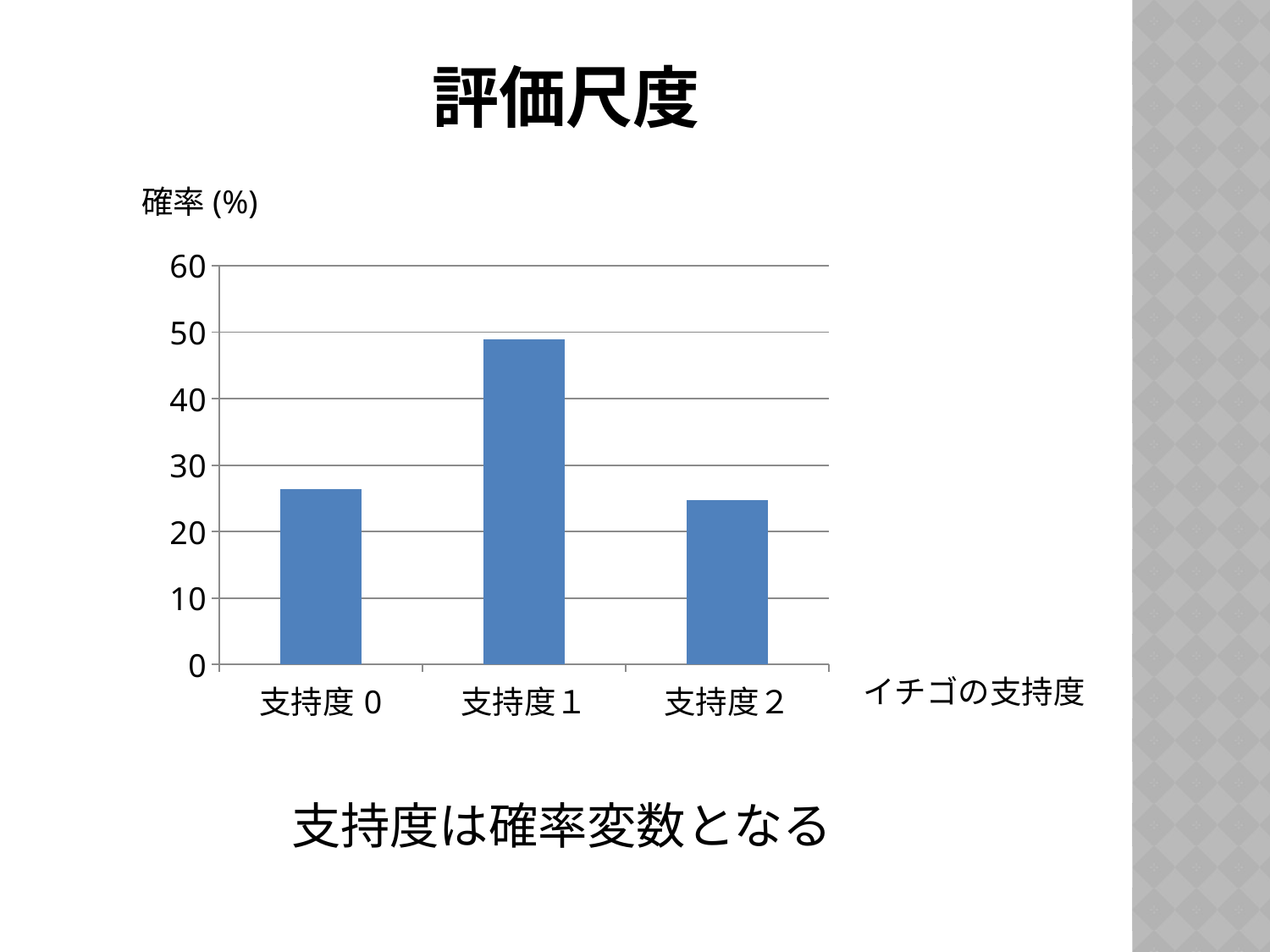
Is the value for 支持度２ greater or less than 20? greater Which is larger, the value for 支持度１ or the value for 支持度２? 支持度１ Is the value for 支持度 0 greater or less than 30? less What kind of chart is shown on the slide? bar chart Which category has the highest value in the chart? 支持度１ Is the value for 支持度２ greater or less than 30? less Which is larger, the value for 支持度 0 or the value for 支持度１? 支持度１ What is the label shown next to the horizontal axis of the chart? イチゴの支持度 What is the label of the vertical axis of the chart? 確率 (%) How many categories are shown on the x axis of the chart? 3